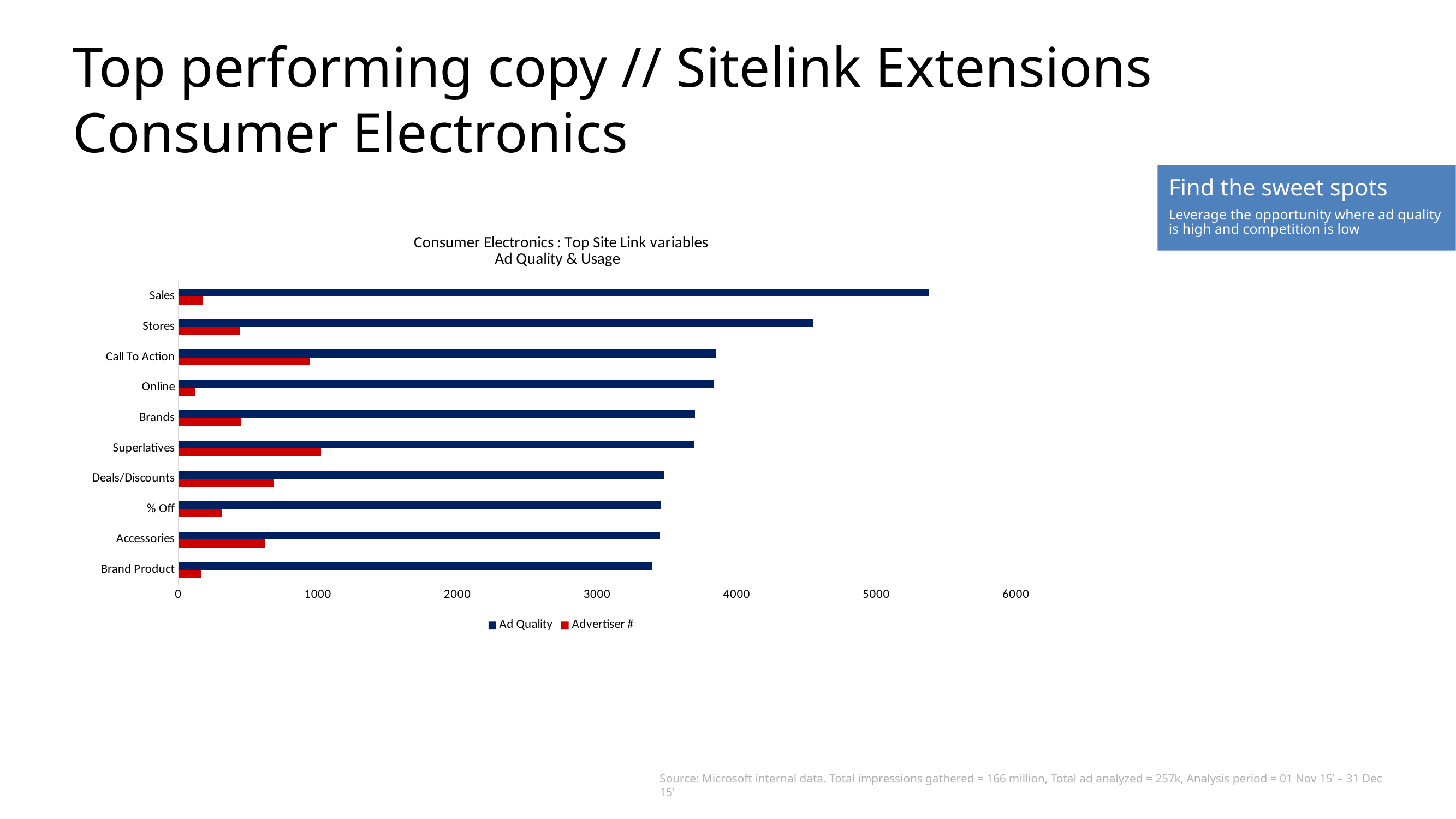
How many categories are plotted on the chart? 10 Is the Ad Quality value for Brand Product greater or less than 3000? greater Is the Ad Quality value for Sales greater or less than 5000? greater Which is larger: the Ad Quality value for Sales or the Ad Quality value for Stores? Sales Is the Ad Quality value for Stores greater or less than 4000? greater What is the title of the chart? Consumer Electronics : Top Site Link variables Ad Quality & Usage Which category has the highest Ad Quality value? Sales Which category has the lowest Advertiser # value? Online What type of chart is shown on the slide? bar chart Which is larger: the Advertiser # value for Call To Action or the Advertiser # value for Online? Call To Action How many series does the legend list? 2